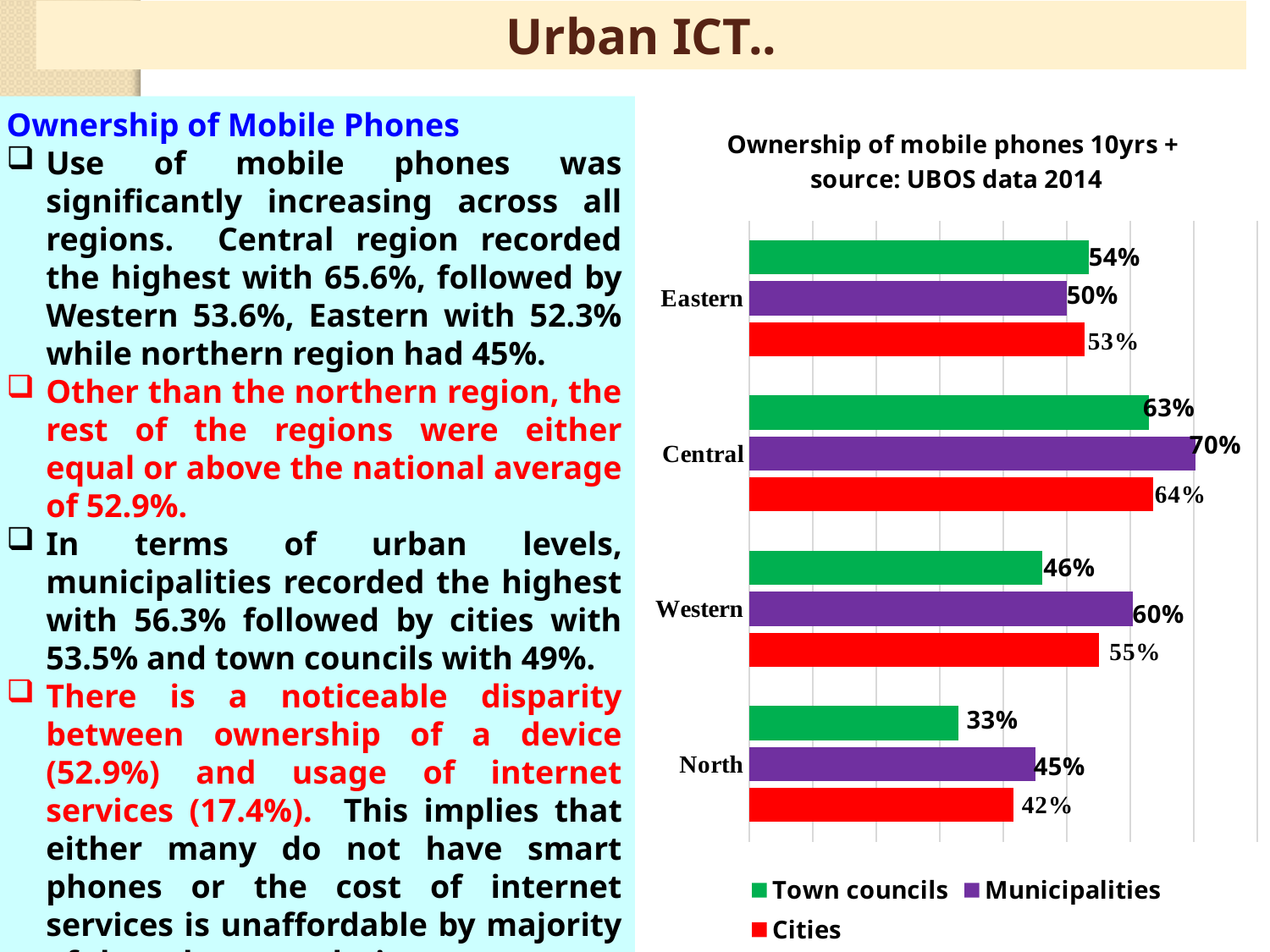
Which colour represents Cities in the chart? Red How many series does the legend list? 3 What is the value for Cities in the Western region? 55% What is the title of the chart? Ownership of mobile phones 10yrs + source: UBOS data 2014 What is the difference between the Municipalities and Town councils values in the Western region? 14% What is the value for Town councils in the North region? 33% Which is larger in the Eastern region, the Town councils value or the Municipalities value? Town councils What is the value for Municipalities in the Central region? 70% Which region has the highest value for Municipalities? Central Which region has the lowest value for Town councils? North What type of chart is shown on the slide? Bar chart How many regions are shown on the chart? 4